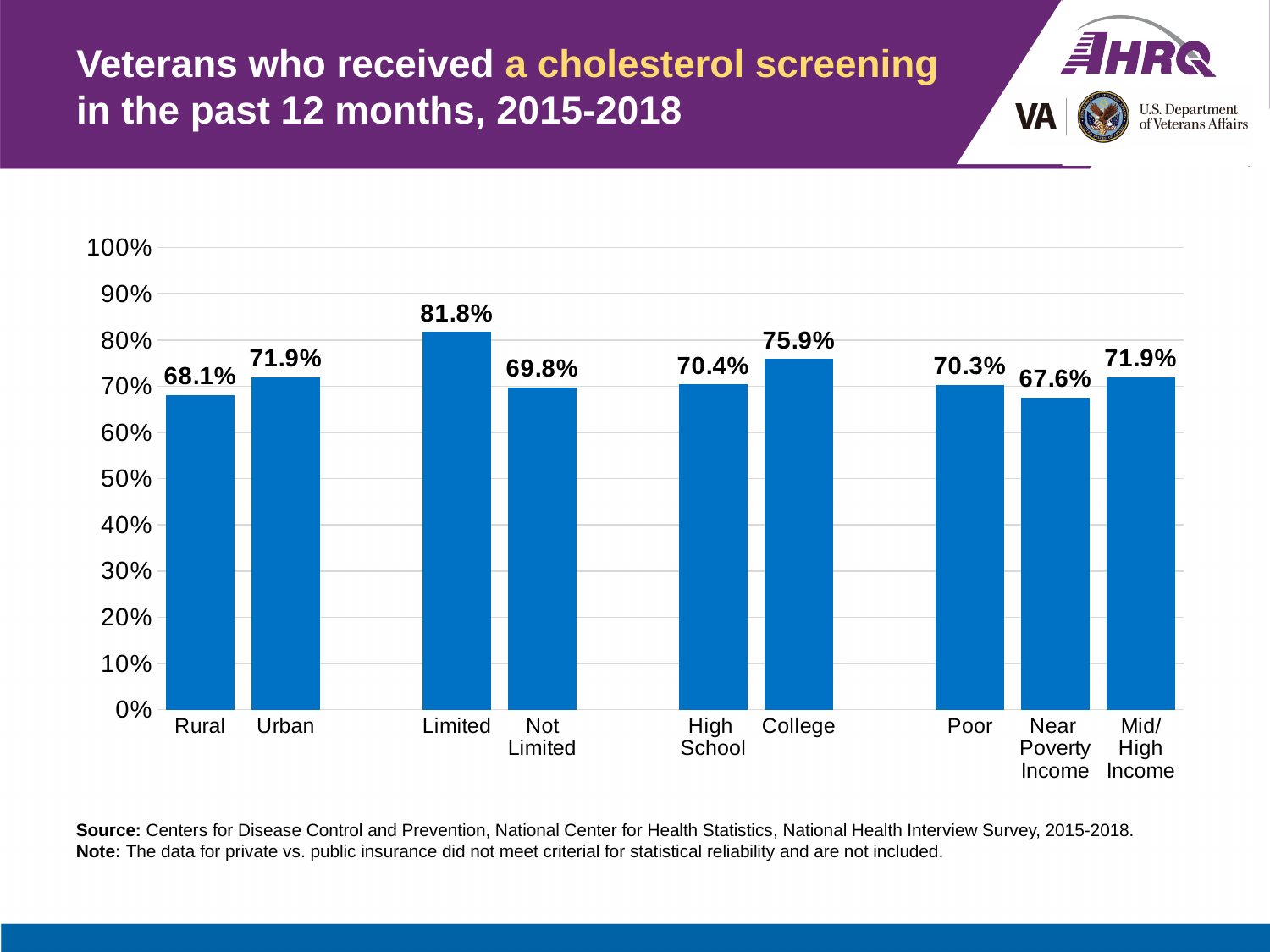
Which category has the lowest value on the chart? Near Poverty Income Which is larger, the value for College or the value for High School? College What is the difference between the Urban and Rural values? 3.8% What kind of chart is shown on the slide? Bar chart How many categories are shown on the chart? 9 What is the value shown for College? 75.9% What percentage of Rural veterans received a cholesterol screening in the past 12 months? 68.1% What is the difference between the Limited and Not Limited values? 12.0% Is the value for Poor greater or less than 60%? greater What is the value shown for Near Poverty Income? 67.6% What is the value shown for the Limited category? 81.8% Which category has the highest value on the chart? Limited